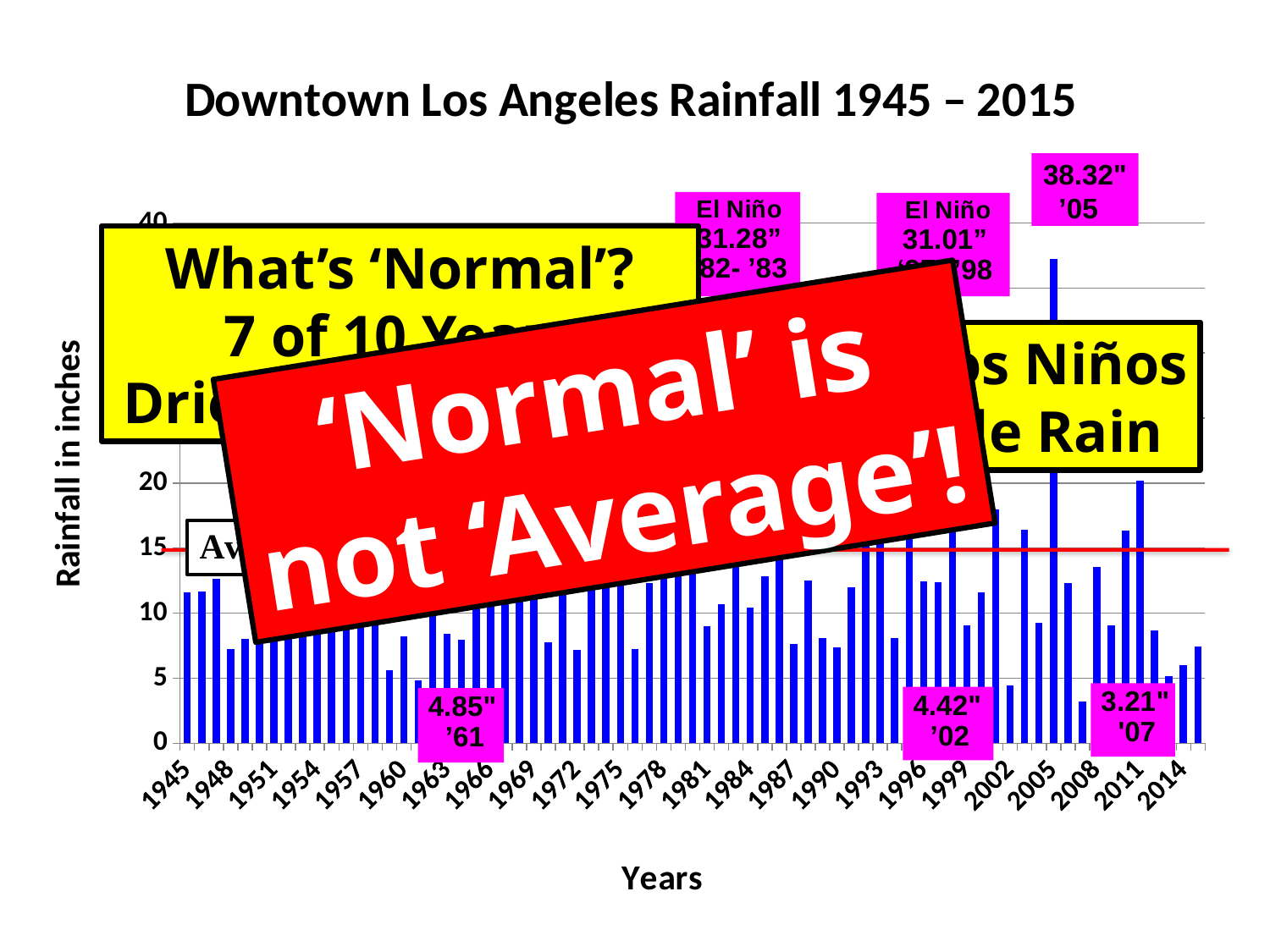
What is the title of the chart? Downtown Los Angeles Rainfall 1945 – 2015 What rainfall value is labeled for '07? 3.21" What kind of chart is shown on the slide? bar chart Which year has the highest rainfall in the chart? '05 Which has more rainfall, '61 or '02? '61 What is the difference between the labeled rainfall for '05 and for '07? 35.11" What rainfall value is labeled for the El Niño year '82-'83? 31.28" What rainfall value is labeled for '05? 38.32" What is the label of the vertical axis? Rainfall in inches What rainfall value is labeled for '61? 4.85" Is the rainfall value for 1945 greater or less than 15? less What rainfall value is labeled for '02? 4.42"